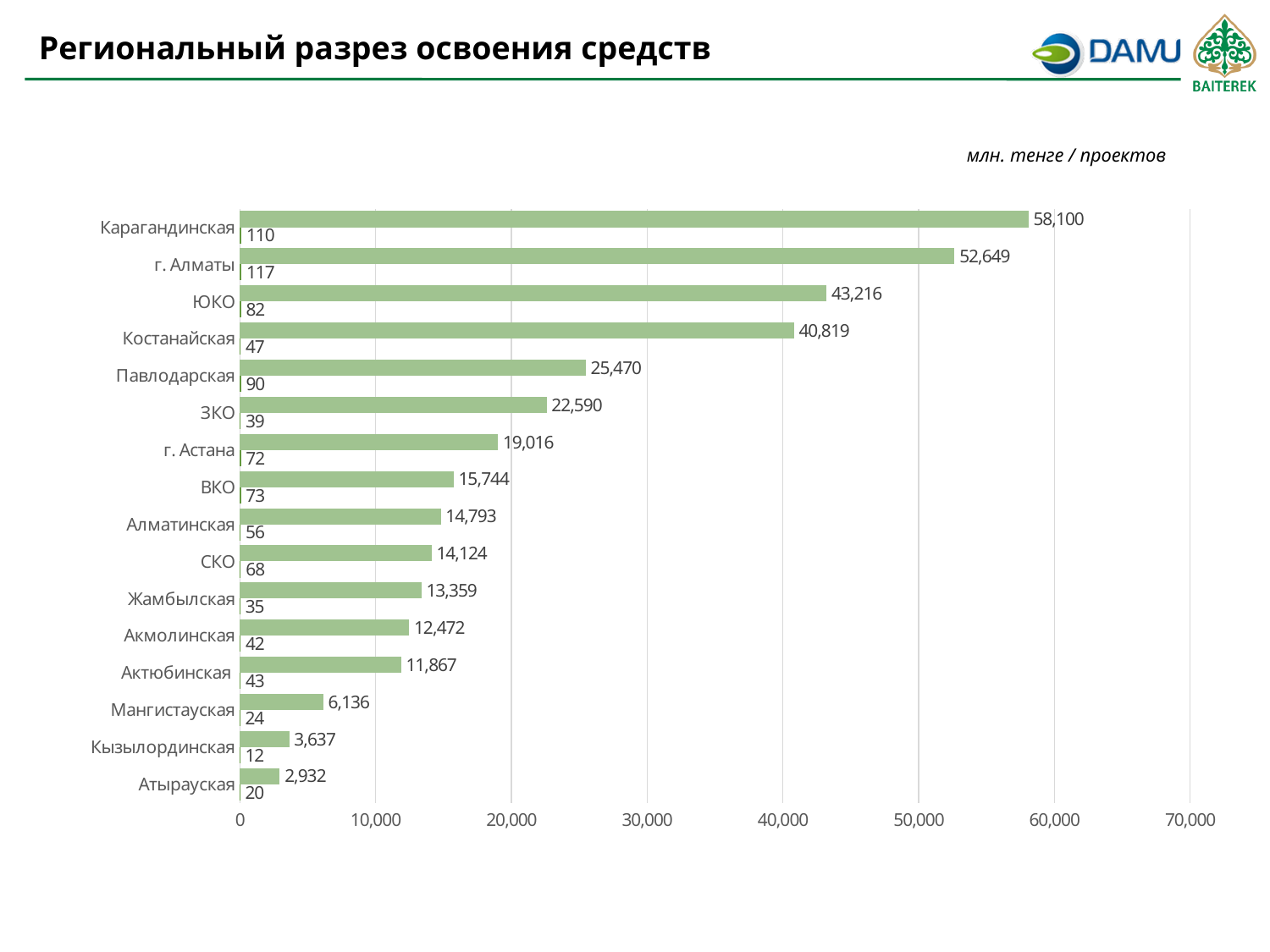
How many regions are shown on the chart? 16 What is the difference in млн. тенге between Карагандинская and г. Алматы? 5,451 Which region has the highest value in млн. тенге? Карагандинская What is the title of the slide? Региональный разрез освоения средств How many projects (проектов) are shown for Кызылординская? 12 Is the value in млн. тенге for ЗКО greater or less than 20,000? greater What type of chart is shown on the slide? Bar chart Which region has the lowest value in млн. тенге? Атырауская How many projects (проектов) are shown for г. Алматы? 117 Which has a larger value in млн. тенге, ЮКО or Костанайская? ЮКО What is the value in млн. тенге for Павлодарская? 25,470 What is the value in млн. тенге for Карагандинская? 58,100